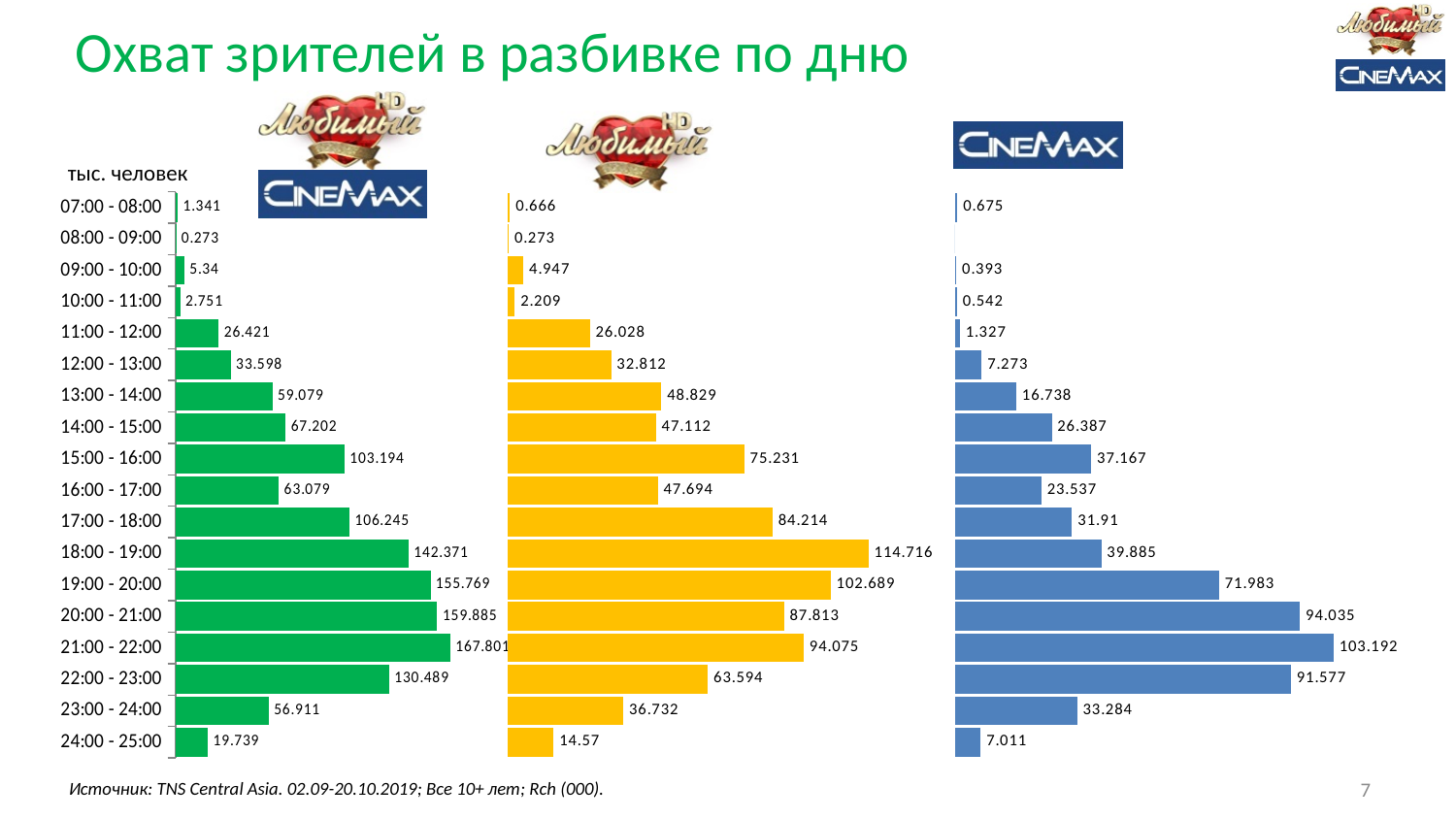
In the middle (yellow) chart, what is the value for 18:00 - 19:00? 114.716 How many time slots are shown in the left (green) chart? 18 What type of chart is used on this slide? Bar chart In the right (blue) chart, which time slot has the highest value? 21:00 - 22:00 In the middle (yellow) chart, which time slot has the lowest value? 08:00 - 09:00 In the left (green) chart, what is the difference between the values for 21:00 - 22:00 and 20:00 - 21:00? 7.916 In the right (blue) chart, what is the value for 20:00 - 21:00? 94.035 In the right (blue) chart, what is the difference between the values for 21:00 - 22:00 and 22:00 - 23:00? 11.615 In the middle (yellow) chart, which time slot has the highest value? 18:00 - 19:00 In the middle (yellow) chart, which is larger: the value for 15:00 - 16:00 or for 16:00 - 17:00? 15:00 - 16:00 In the left (green) chart, which time slot has the highest value? 21:00 - 22:00 In the left (green) chart, what is the value for 21:00 - 22:00? 167.801